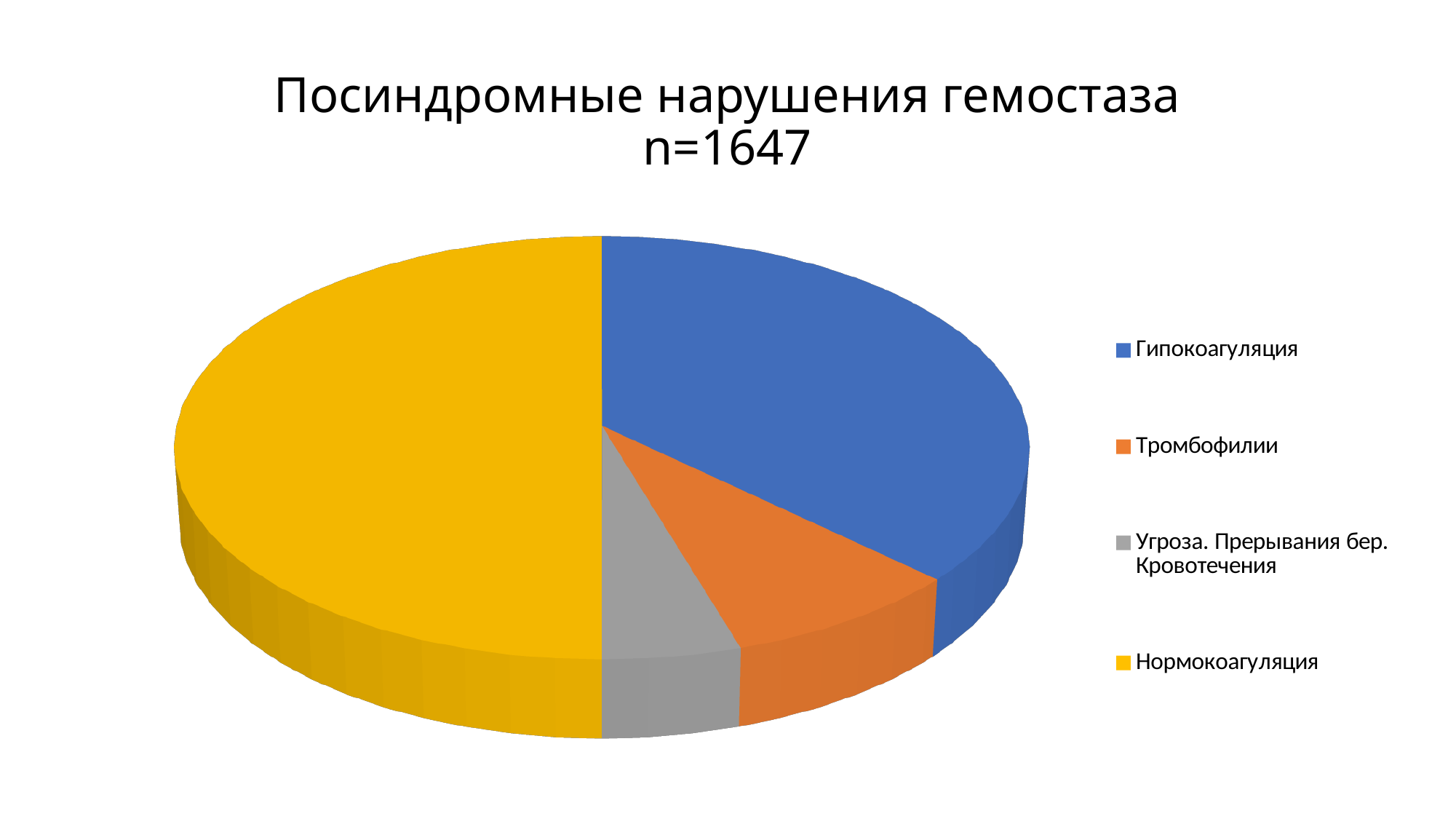
Which category has the largest slice of the pie? Нормокоагуляция How many entries does the legend list? 4 How many categories does the pie chart have? 4 Which slice is larger, Тромбофилии or Угроза. Прерывания бер. Кровотечения? Тромбофилии What colour represents Тромбофилии in the pie chart? orange What kind of chart is shown on the slide? pie chart Which category has the smallest slice of the pie? Угроза. Прерывания бер. Кровотечения Which slice is larger, Гипокоагуляция or Тромбофилии? Гипокоагуляция What is the title of the chart? Посиндромные нарушения гемостаза n=1647 Which slice is larger, Нормокоагуляция or Гипокоагуляция? Нормокоагуляция